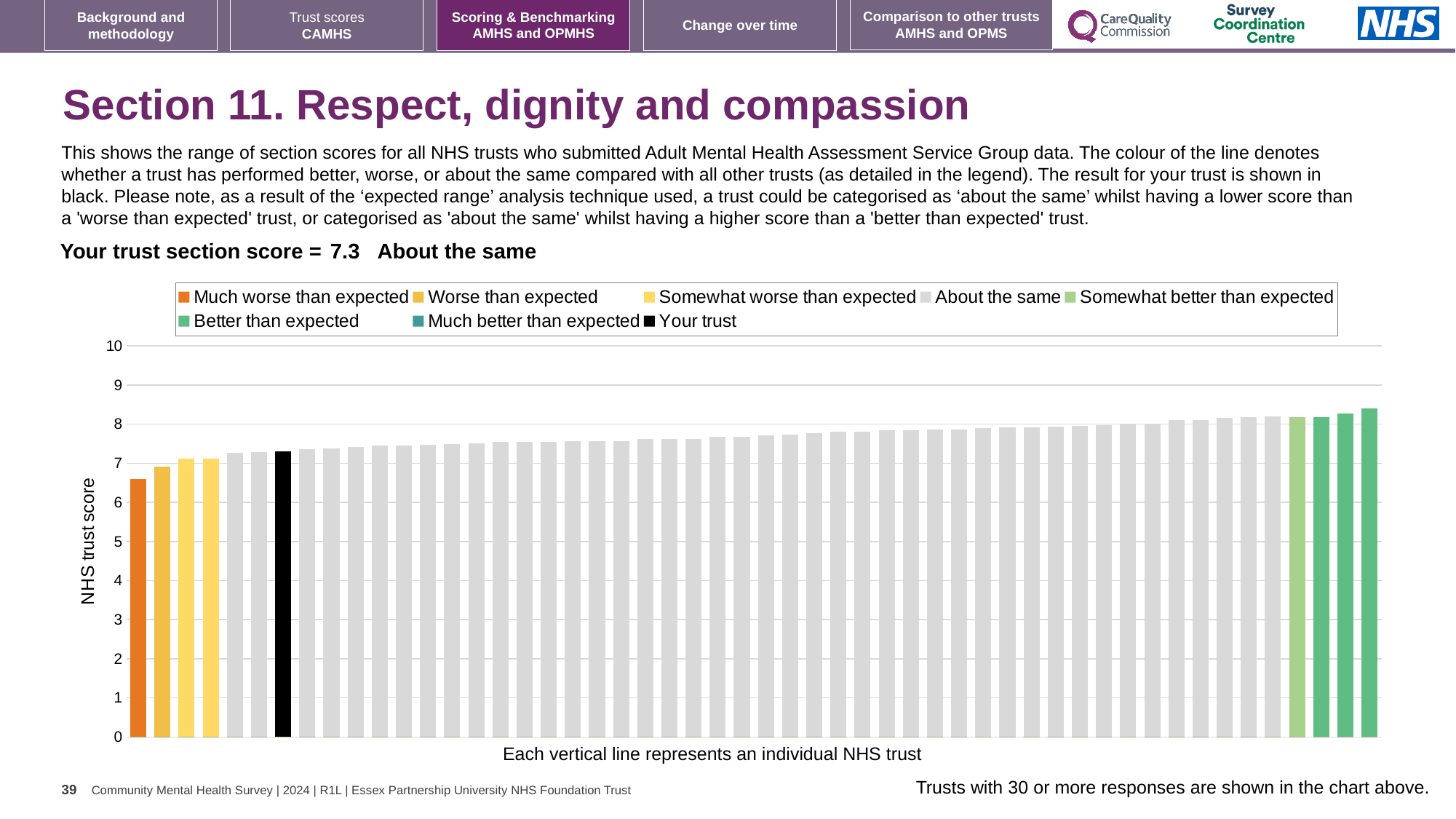
What is the label on the vertical axis of the chart? NHS trust score What kind of chart is shown on the slide? bar chart Is the value of the black 'Your trust' bar greater or less than 7? greater Is the value of the highest bar in the chart greater or less than 9? less How many entries does the chart legend list? 8 How many bars are coloured as 'Much worse than expected'? 1 Which category is your trust's section score placed in? About the same What is the section score for your trust shown on the slide? 7.3 Is the value of the lowest bar (the orange 'Much worse than expected' bar) greater or less than 7? less Do the bar values rise or fall from left to right along the x axis? rise How many bars are coloured as 'Better than expected' (dark green)? 3